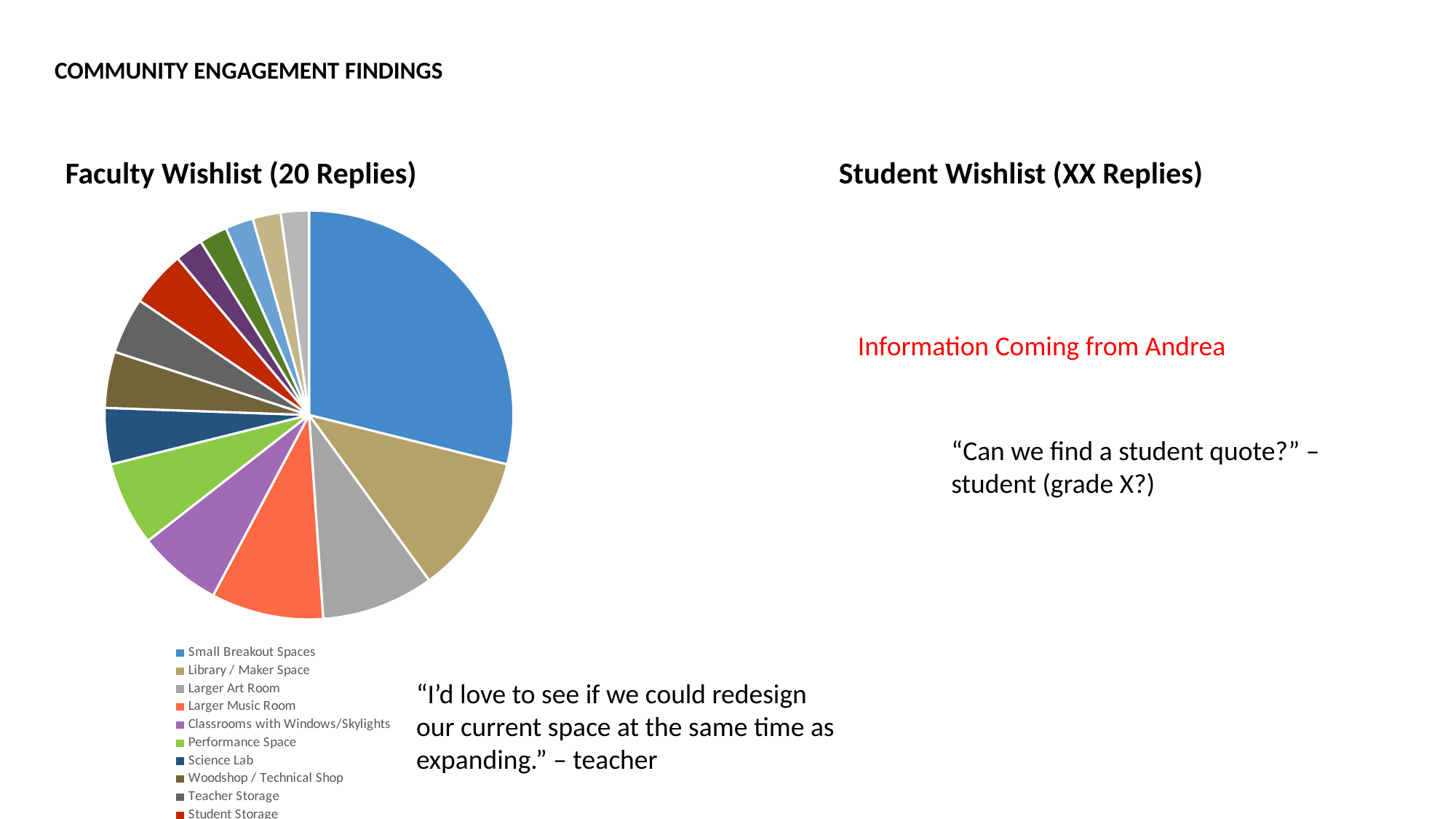
In the Faculty Wishlist pie chart, which slice is larger: Larger Art Room or Woodshop / Technical Shop? Larger Art Room In the Faculty Wishlist pie chart, which slice is larger: Teacher Storage or Small Breakout Spaces? Small Breakout Spaces In the Faculty Wishlist pie chart, which slice is larger: Small Breakout Spaces or Library / Maker Space? Small Breakout Spaces How many replies does the Faculty Wishlist chart title say it is based on? 20 In the Faculty Wishlist pie chart, which category has the largest slice? Small Breakout Spaces What kind of chart is shown under the heading "Faculty Wishlist (20 Replies)"? Pie chart What colour is the Small Breakout Spaces slice in the Faculty Wishlist pie chart? Blue